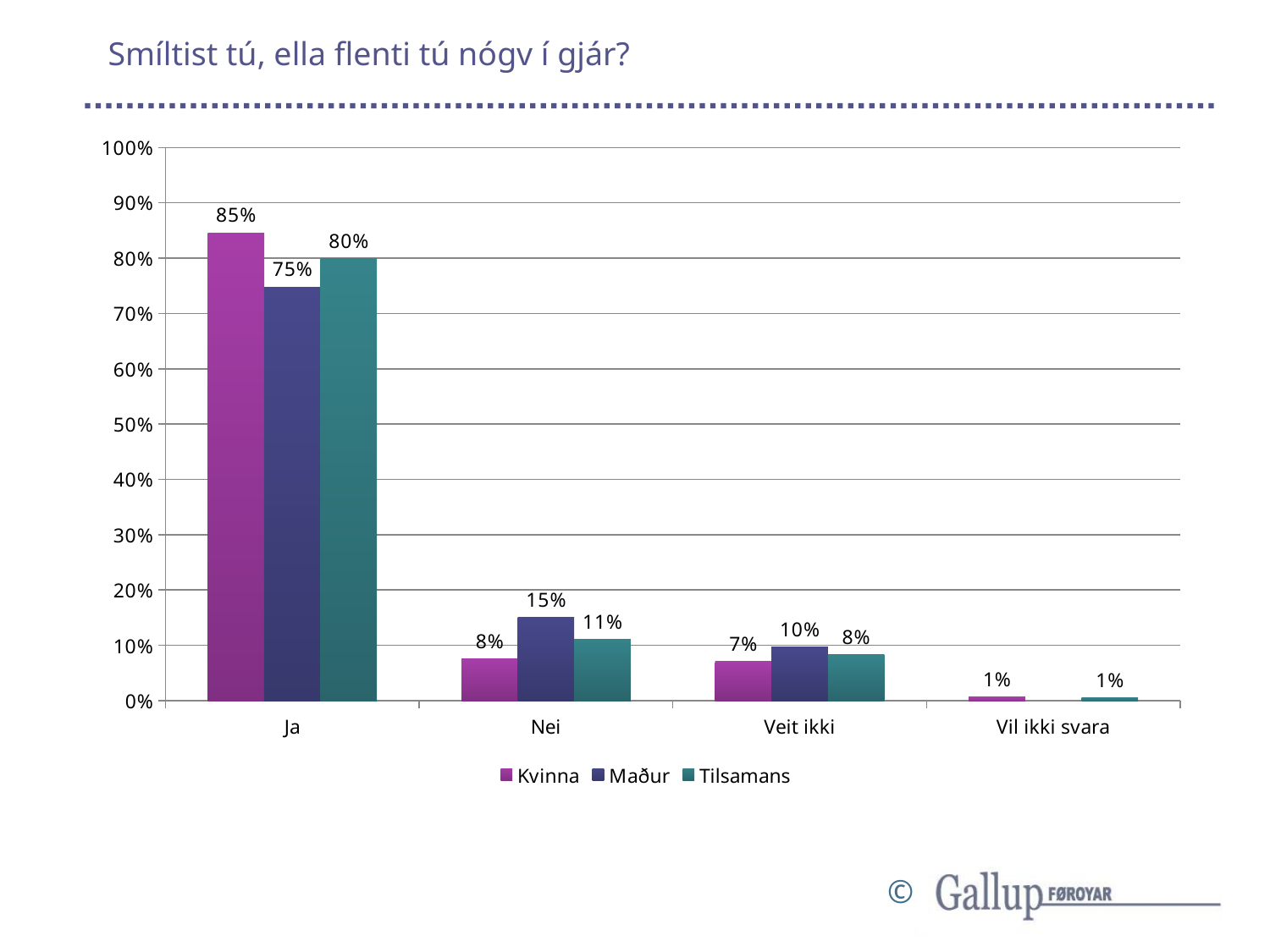
What is the difference between the Kvinna and Maður values in the Ja category? 10% What is the title of the slide? Smíltist tú, ella flenti tú nógv í gjár? Which category has the lowest value for Kvinna? Vil ikki svara Which is larger in the Nei category, the value for Kvinna or for Maður? Maður What is the value for Tilsamans in the Veit ikki category? 8% What is the value for Kvinna in the Ja category? 85% How many categories are shown on the x axis? 4 What is the value for Maður in the Nei category? 15% How many series does the legend list? 3 Which category has the highest value for Tilsamans? Ja What kind of chart is shown on the slide? bar chart Is the value for Tilsamans in the Ja category greater or less than 50%? greater